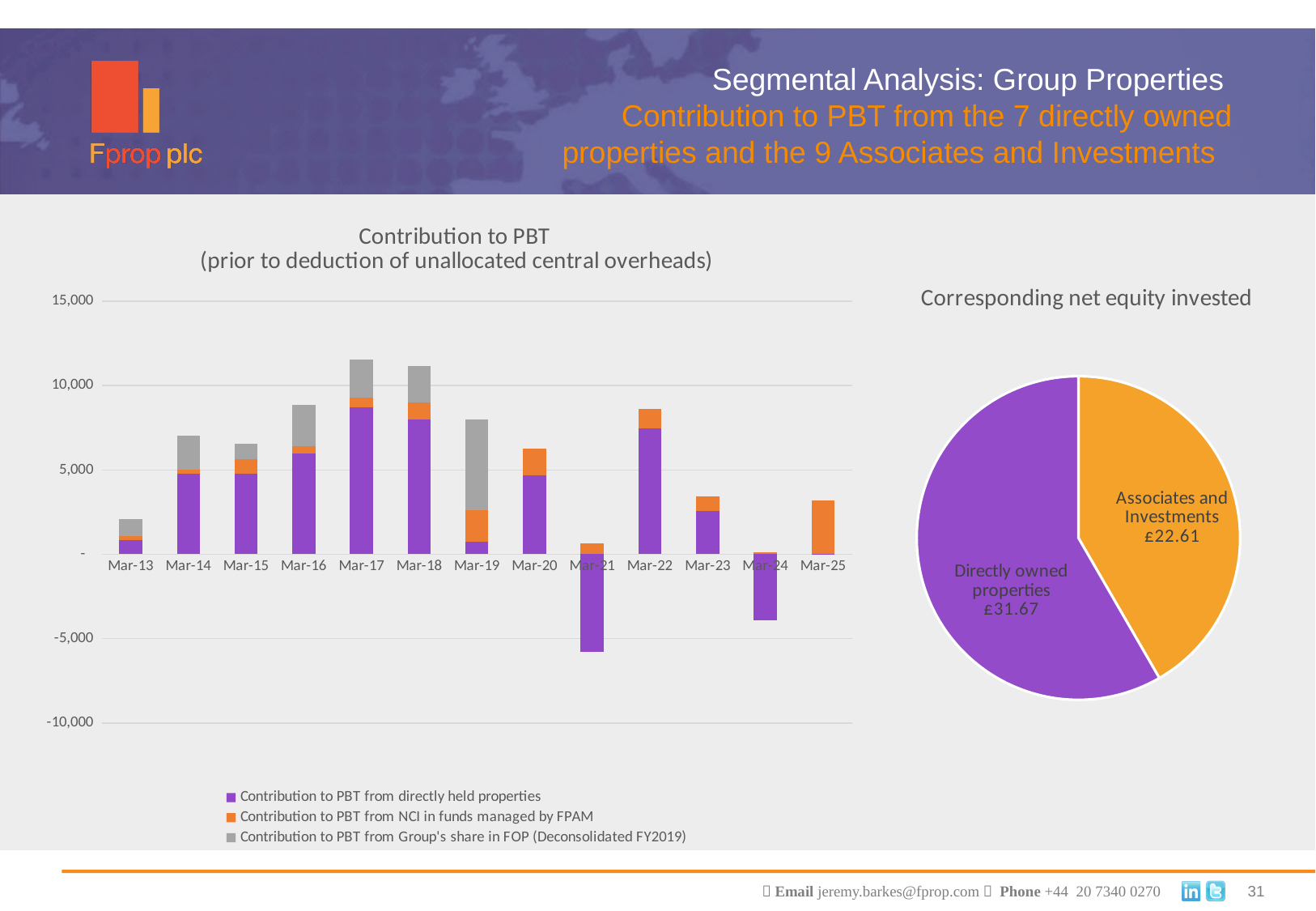
In the 'Corresponding net equity invested' pie chart, which slice is larger: Directly owned properties or Associates and Investments? Directly owned properties In the 'Contribution to PBT' bar chart, is the value for directly held properties in Mar-21 greater or less than -5,000? less In the 'Contribution to PBT' bar chart, is the total stacked value for Mar-17 greater or less than 10,000? greater In the 'Contribution to PBT' bar chart, is the total stacked value for Mar-13 greater or less than 5,000? less In the 'Corresponding net equity invested' pie chart, what is the value for Directly owned properties? £31.67 How many series does the legend of the 'Contribution to PBT' bar chart list? 3 In the 'Contribution to PBT' bar chart, how many year categories are shown on the x axis? 13 What kind of chart is the 'Corresponding net equity invested' chart on the right of the slide? Pie chart In the 'Corresponding net equity invested' pie chart, what is the value for Associates and Investments? £22.61 What kind of chart is the 'Contribution to PBT' chart on the left of the slide? Stacked bar chart In the 'Corresponding net equity invested' pie chart, what is the difference between the Directly owned properties value and the Associates and Investments value? £9.06 In the 'Contribution to PBT' bar chart, which year has the lowest (most negative) contribution from directly held properties? Mar-21